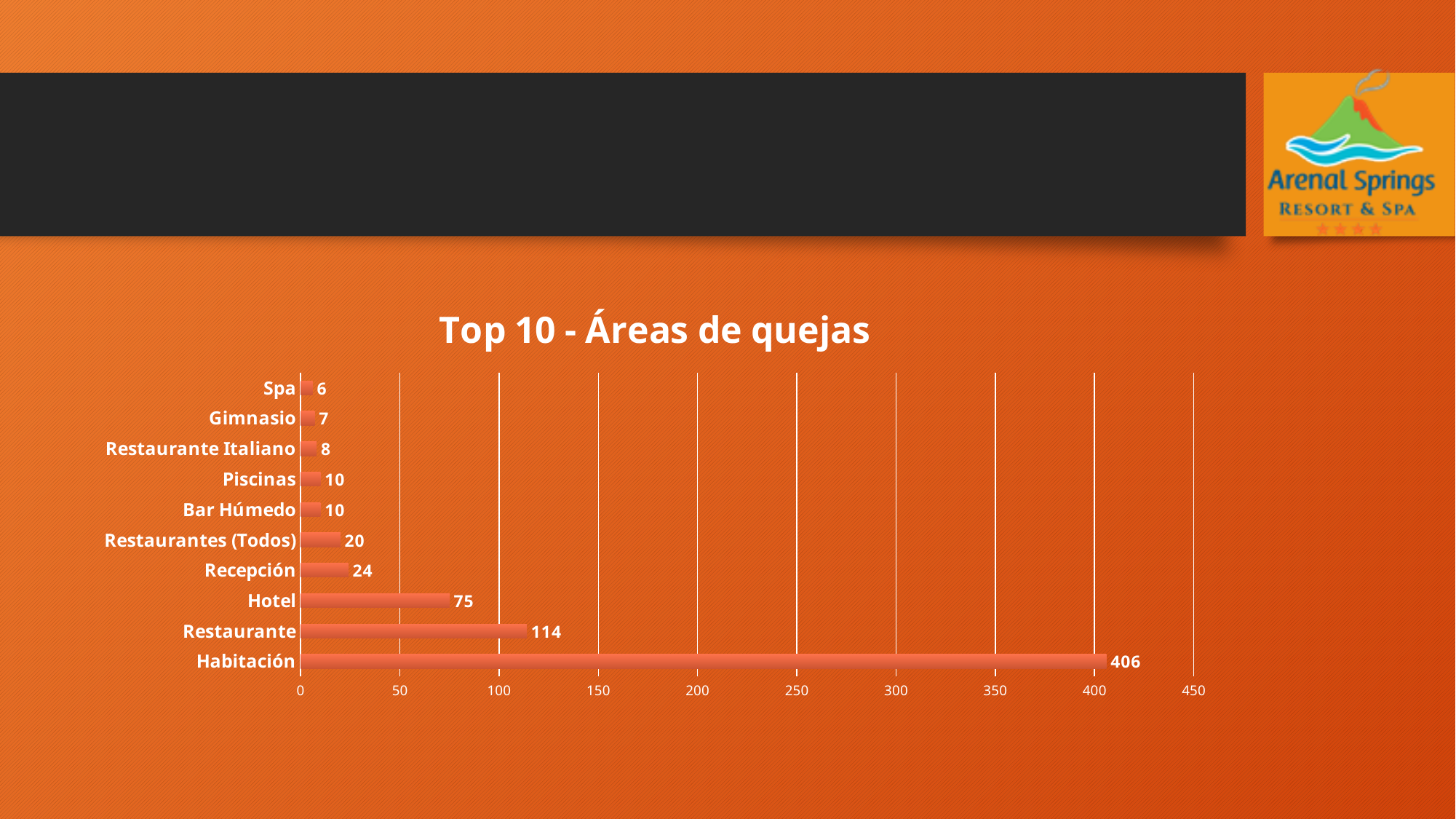
What is the difference between the values for Habitación and Restaurante? 292 What is the value for Habitación? 406 What is the difference between the values for Hotel and Recepción? 51 Which category has the highest value? Habitación What is the title of the chart? Top 10 - Áreas de quejas How many categories are shown in the chart? 10 Which category has the lowest value? Spa Is the value for Restaurante greater or less than 100? greater What kind of chart is shown on the slide? bar chart What is the value for Recepción? 24 Which is larger, the value for Hotel or the value for Restaurantes (Todos)? Hotel What is the value for Restaurante? 114